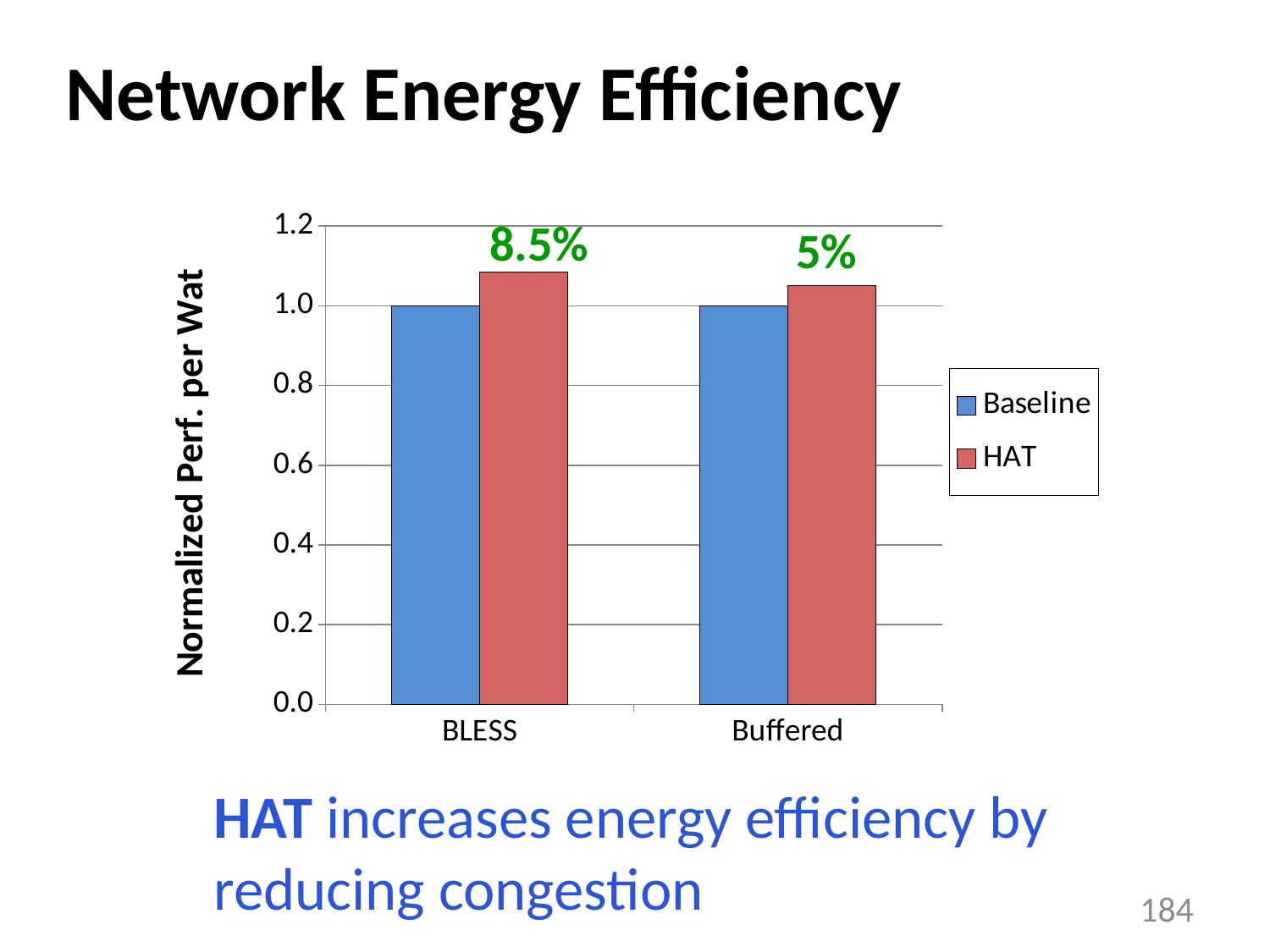
Is the HAT value for Buffered greater or less than 1.2? less What percentage improvement is annotated above the BLESS bars? 8.5% What is the Baseline value for Buffered? 1.0 For BLESS, which is larger: Baseline or HAT? HAT Which HAT bar is taller: BLESS or Buffered? BLESS Is the HAT value for BLESS greater or less than 1.0? greater What type of chart is shown on the slide? bar chart How many series does the legend list? 2 What percentage improvement is annotated above the Buffered bars? 5% What is the Baseline value for BLESS? 1.0 What is the label of the y axis? Normalized Perf. per Wat How many categories are shown on the x axis? 2